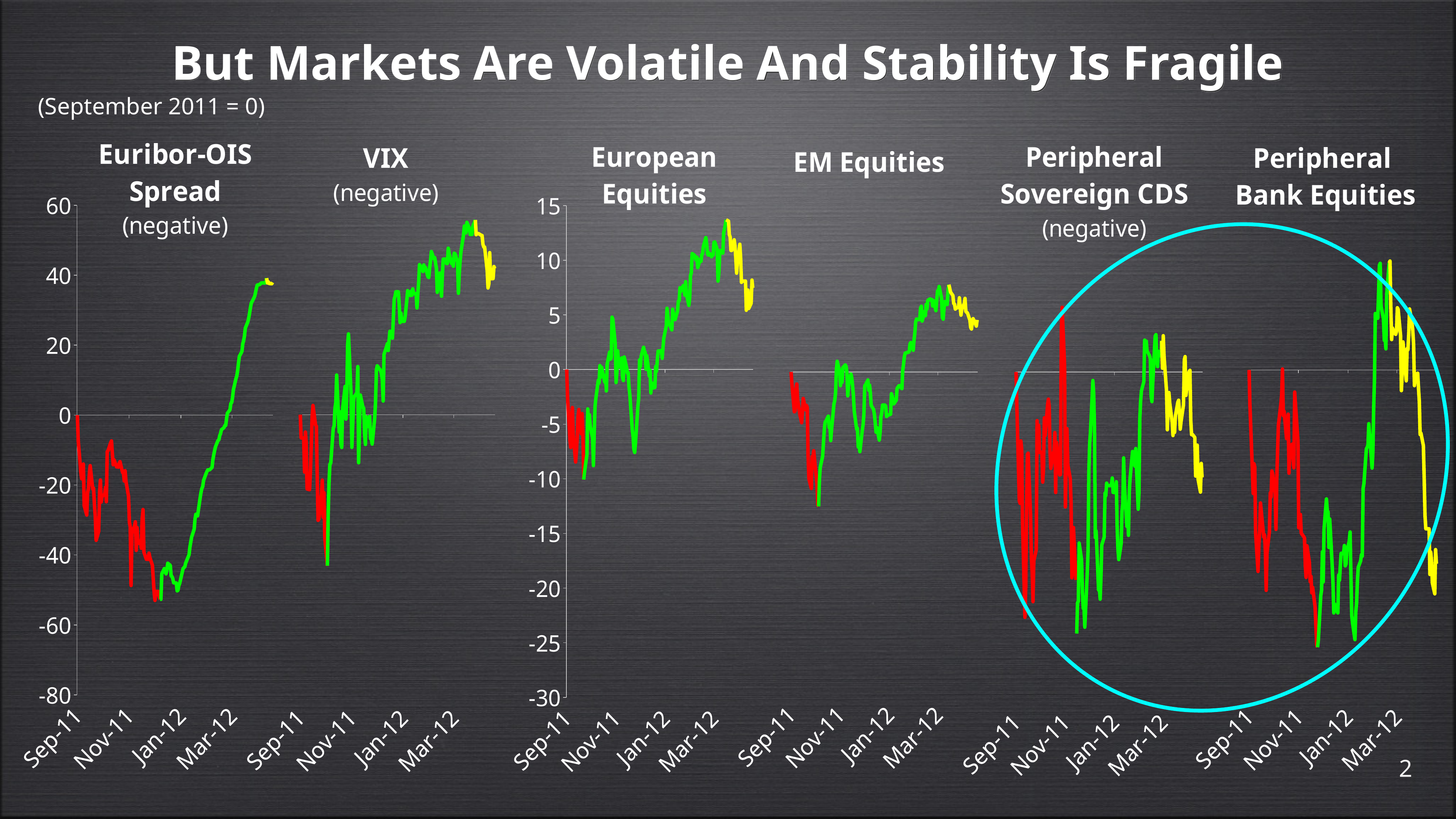
What kind of charts are shown on the slide? Line charts In the European Equities chart, is the highest point of the line greater or less than 10? greater In the Euribor-OIS Spread chart, is the lowest point of the line greater or less than -40? less In the Peripheral Sovereign CDS chart, is the lowest point of the line greater or less than -20? less In the European Equities chart, does the line overall rise or fall from Sep-11 to Mar-12? rise In the Euribor-OIS Spread chart, does the line overall rise or fall from Sep-11 to Mar-12? rise What is the title of the slide? But Markets Are Volatile And Stability Is Fragile How many separate charts are shown on the slide? 6 Which two charts are enclosed by the cyan circle? Peripheral Sovereign CDS and Peripheral Bank Equities